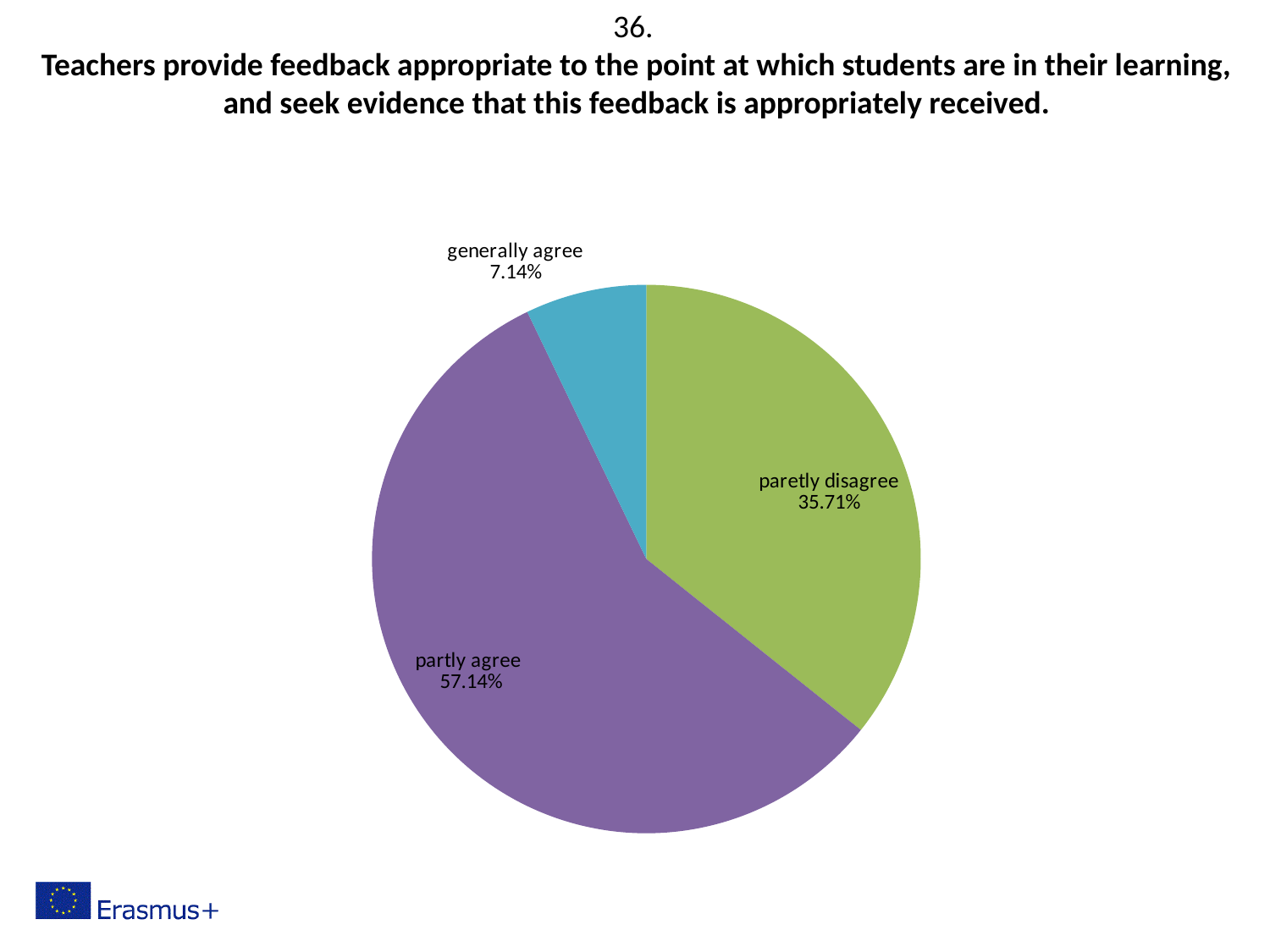
What kind of chart is shown on the slide? pie chart What percentage of respondents chose "partly agree"? 57.14% How many slices does the pie chart have? 3 What colour is the "partly agree" slice? purple Which is larger: the share for "paretly disagree" or the share for "generally agree"? paretly disagree What colour is the "generally agree" slice? blue What percentage of respondents chose "paretly disagree"? 35.71% Which response category has the largest share of the pie? partly agree What is the difference in percentage points between "partly agree" and "paretly disagree"? 21.43 Which response category has the smallest share of the pie? generally agree What is the combined share of "partly agree" and "generally agree"? 64.28% What percentage of respondents chose "generally agree"? 7.14%